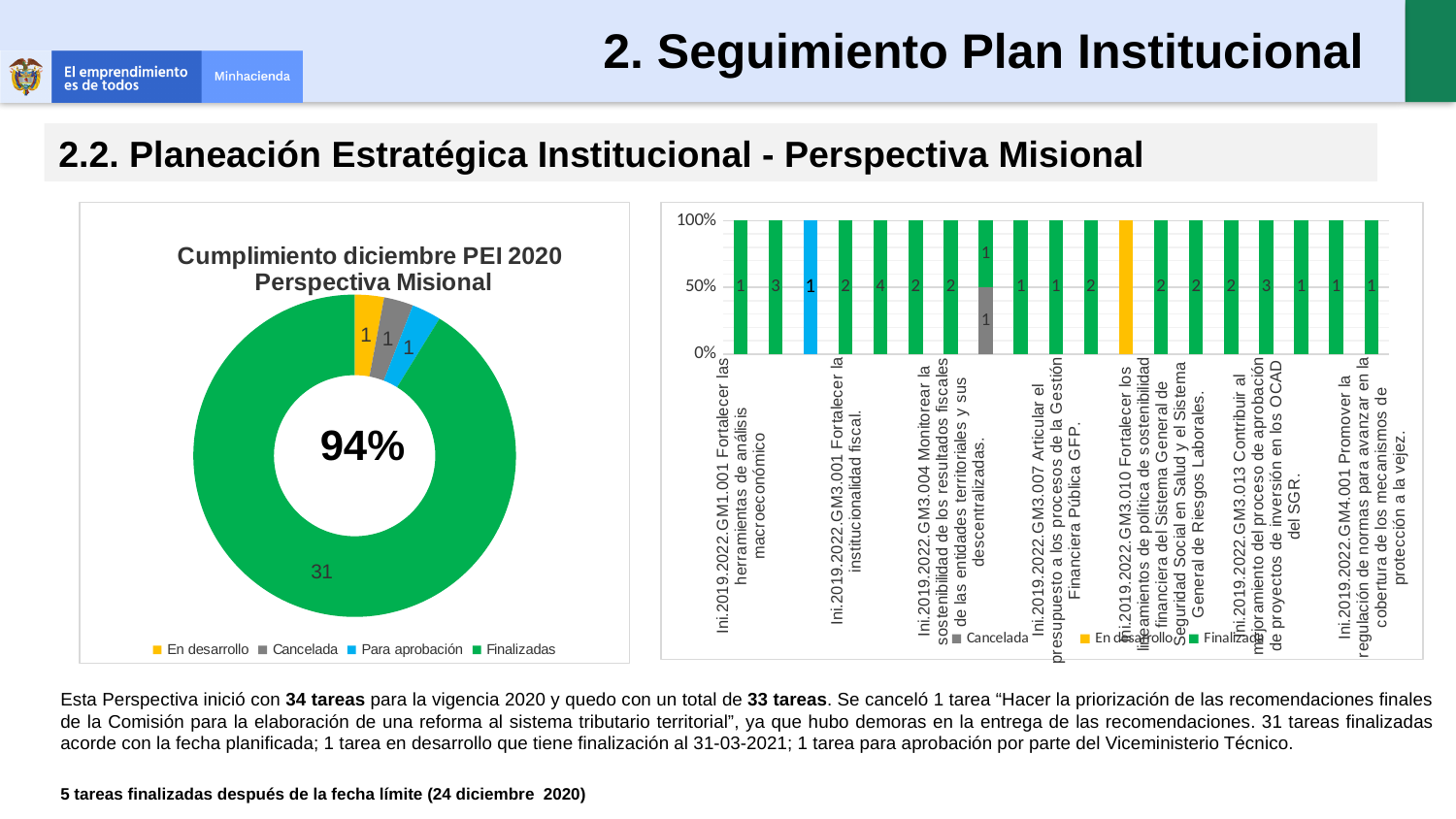
In the chart titled 'Cumplimiento diciembre PEI 2020 Perspectiva Misional', what is the total of all the slices? 34 In the chart titled 'Cumplimiento diciembre PEI 2020 Perspectiva Misional', what is the difference between the Finalizadas value and the En desarrollo value? 30 What percentage is shown in the centre of the doughnut chart 'Cumplimiento diciembre PEI 2020 Perspectiva Misional'? 94% In the chart titled 'Cumplimiento diciembre PEI 2020 Perspectiva Misional', what is the value for Cancelada? 1 In the stacked bar chart on the right, what value is labelled on the bar for 'Ini.2019.2022.GM1.001 Fortalecer las herramientas de análisis macroeconómico'? 1 In the chart titled 'Cumplimiento diciembre PEI 2020 Perspectiva Misional', which category has the largest slice? Finalizadas In the chart titled 'Cumplimiento diciembre PEI 2020 Perspectiva Misional', what is the value for Finalizadas? 31 How many entries does the legend of the chart 'Cumplimiento diciembre PEI 2020 Perspectiva Misional' list? 4 What kind of chart is 'Cumplimiento diciembre PEI 2020 Perspectiva Misional'? Doughnut (pie) chart What kind of chart is the chart on the right of the slide? Stacked bar chart